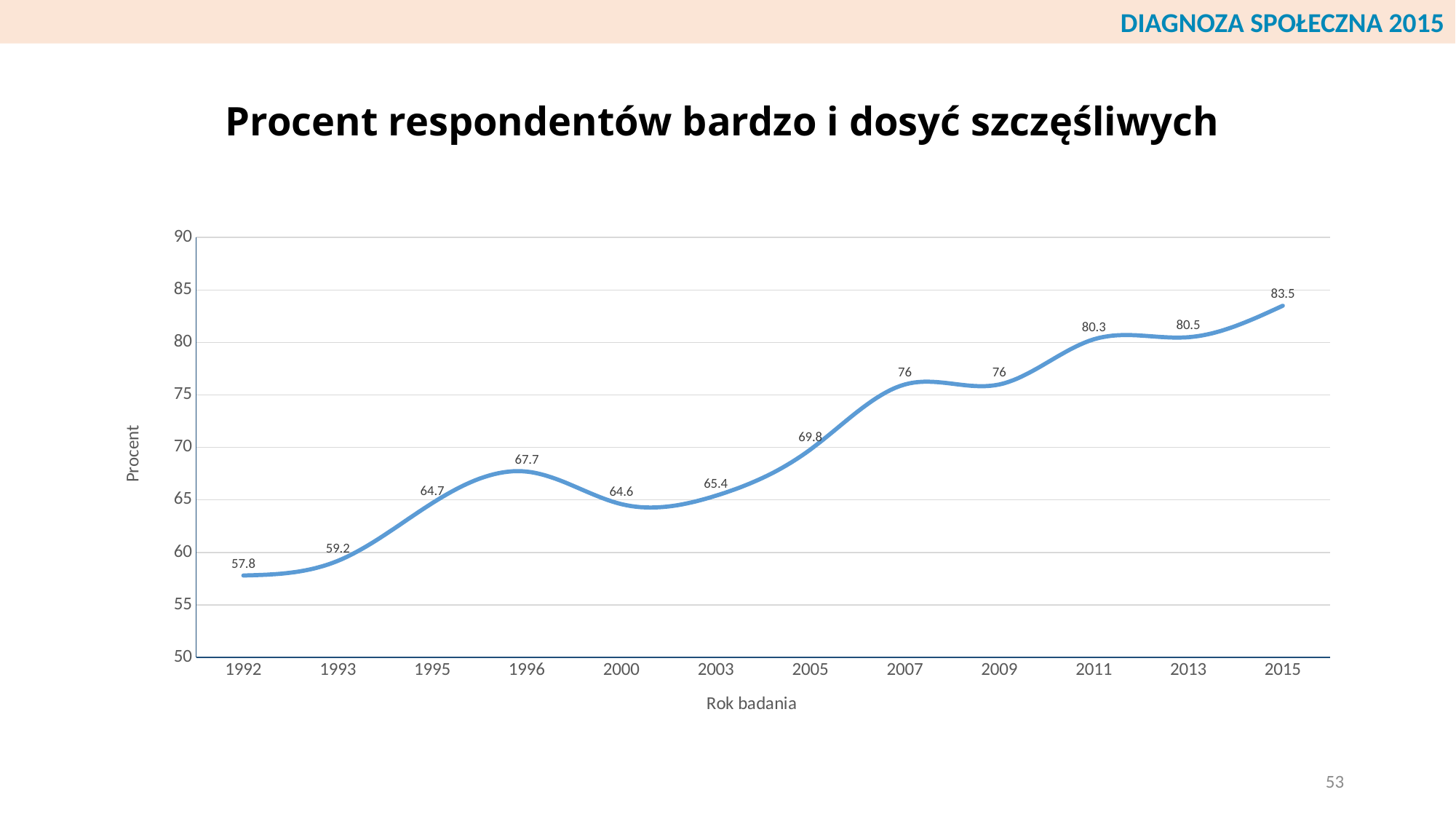
Which is larger, the value for 1996 or the value for 2000? 1996 How many years are plotted on the x axis? 12 What is the value for 2011? 80.3 What kind of chart is shown? line chart What is the value for 2015? 83.5 Is the value for 2005 greater or less than 70? less What is the label of the x axis? Rok badania Which year has the lowest value? 1992 What is the value for 1992? 57.8 Which year has the highest value? 2015 What is the value for 2000? 64.6 What is the difference between the values for 2015 and 1992? 25.7